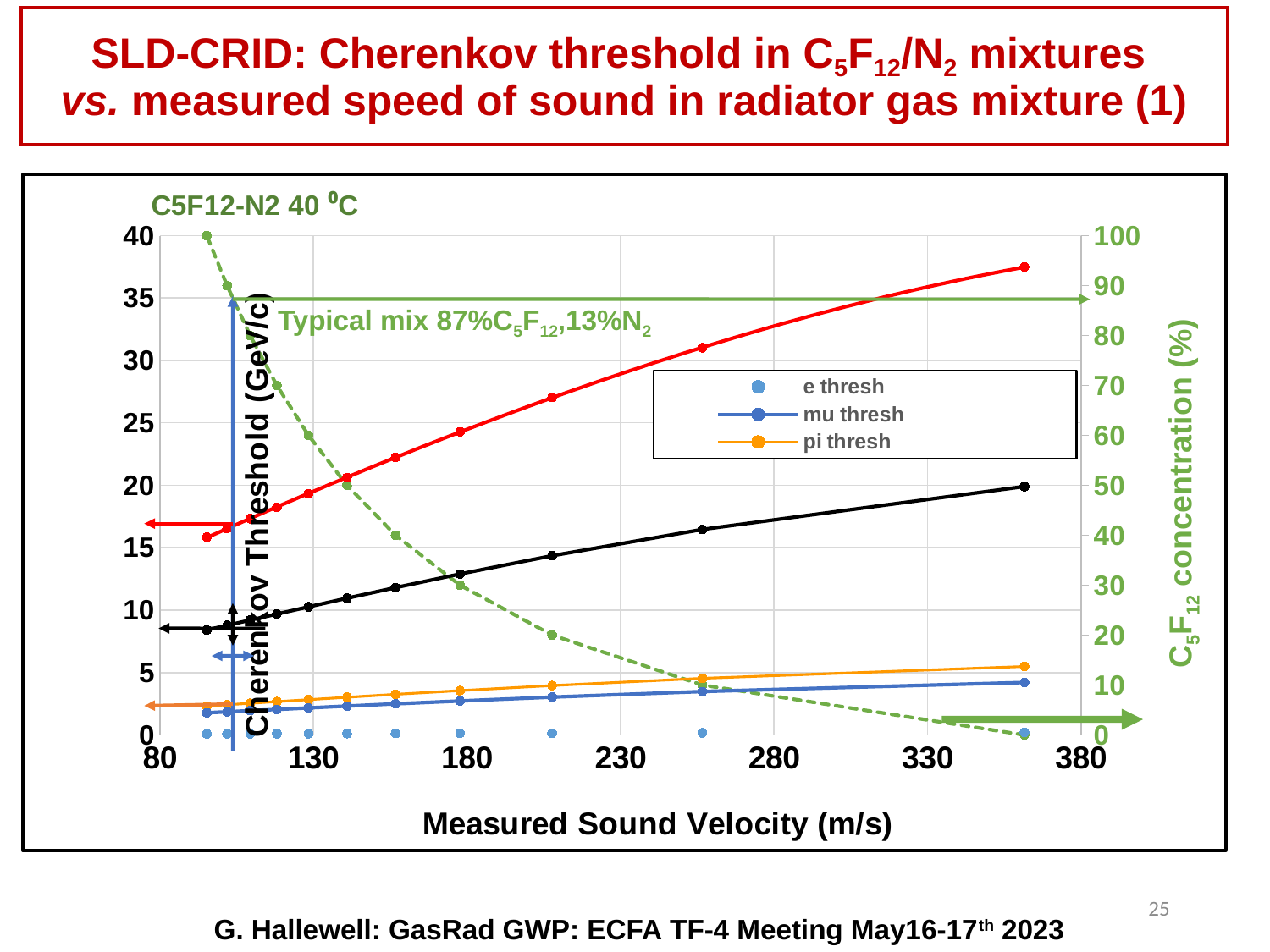
At the rightmost data point, which is higher: pi thresh or e thresh? pi thresh At the rightmost data point, which is higher: the red line or the black line? red line Does the red line rise or fall as measured sound velocity increases? rise Does the green dashed line rise or fall as measured sound velocity increases? fall Is the value of the black line at its rightmost point greater or less than 15 on the left axis? greater Is the value of the mu thresh series at its rightmost point greater or less than 5 on the left axis? less Is the value of the red line at its leftmost point greater or less than 20 on the left axis? less What is the title of the left y axis? Cherenkov Threshold (GeV/c) What kind of chart is shown on the slide? line chart What is the title of the x axis? Measured Sound Velocity (m/s) How many series does the chart's legend list? 3